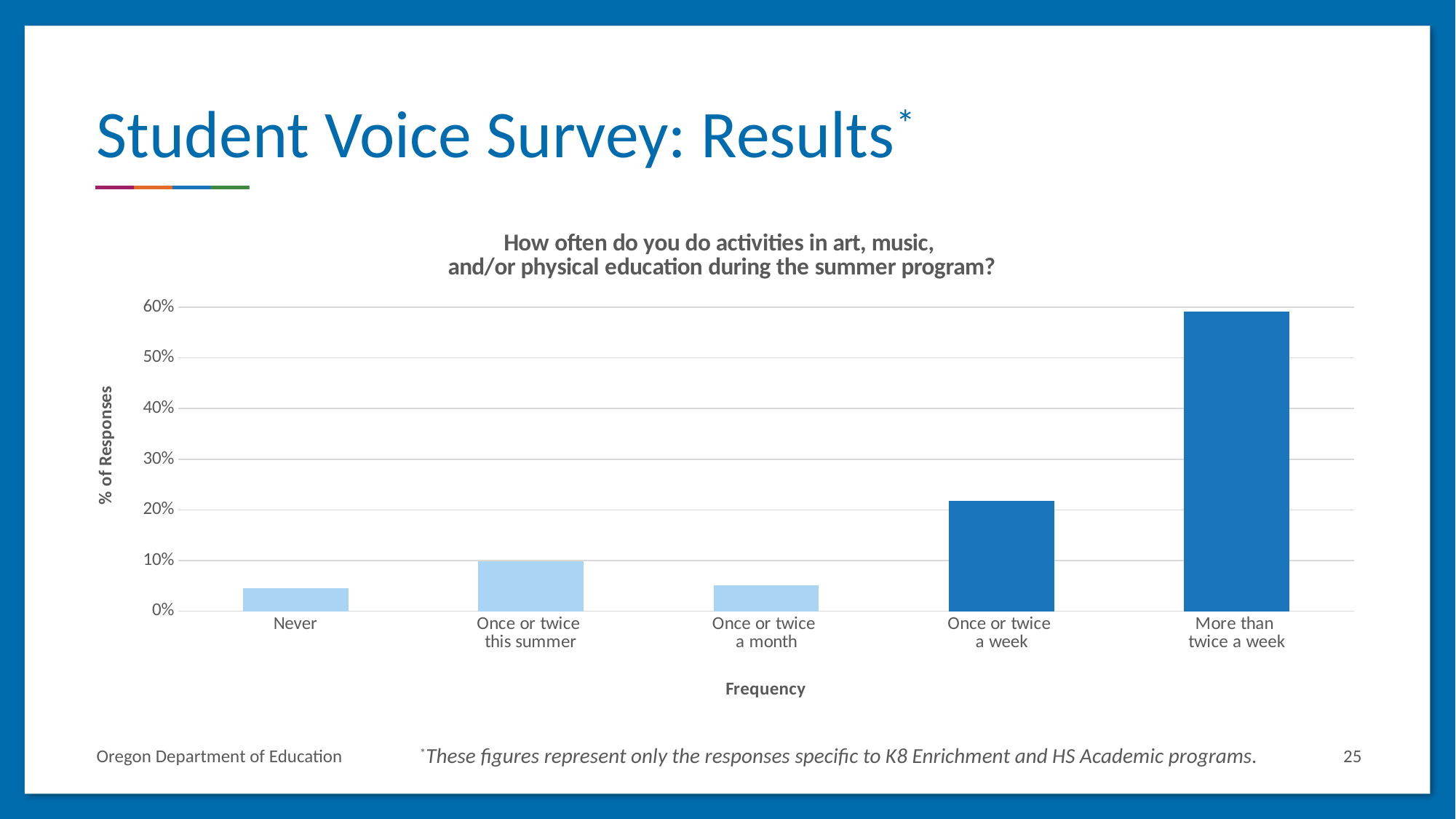
Which frequency category has the highest percentage of responses? More than twice a week Is the value for "Never" greater or less than 10%? less Is the value for "More than twice a week" greater or less than 50%? greater What is the title of the horizontal axis of the chart? Frequency Is the value for "Once or twice a week" greater or less than 30%? less What kind of chart is shown on the slide? bar chart Which has a higher percentage of responses: "Once or twice this summer" or "Once or twice a month"? Once or twice this summer How many frequency categories are shown on the x axis of the chart? 5 What is the title of the vertical axis of the chart? % of Responses Which has a higher percentage of responses: "Once or twice a week" or "Once or twice this summer"? Once or twice a week